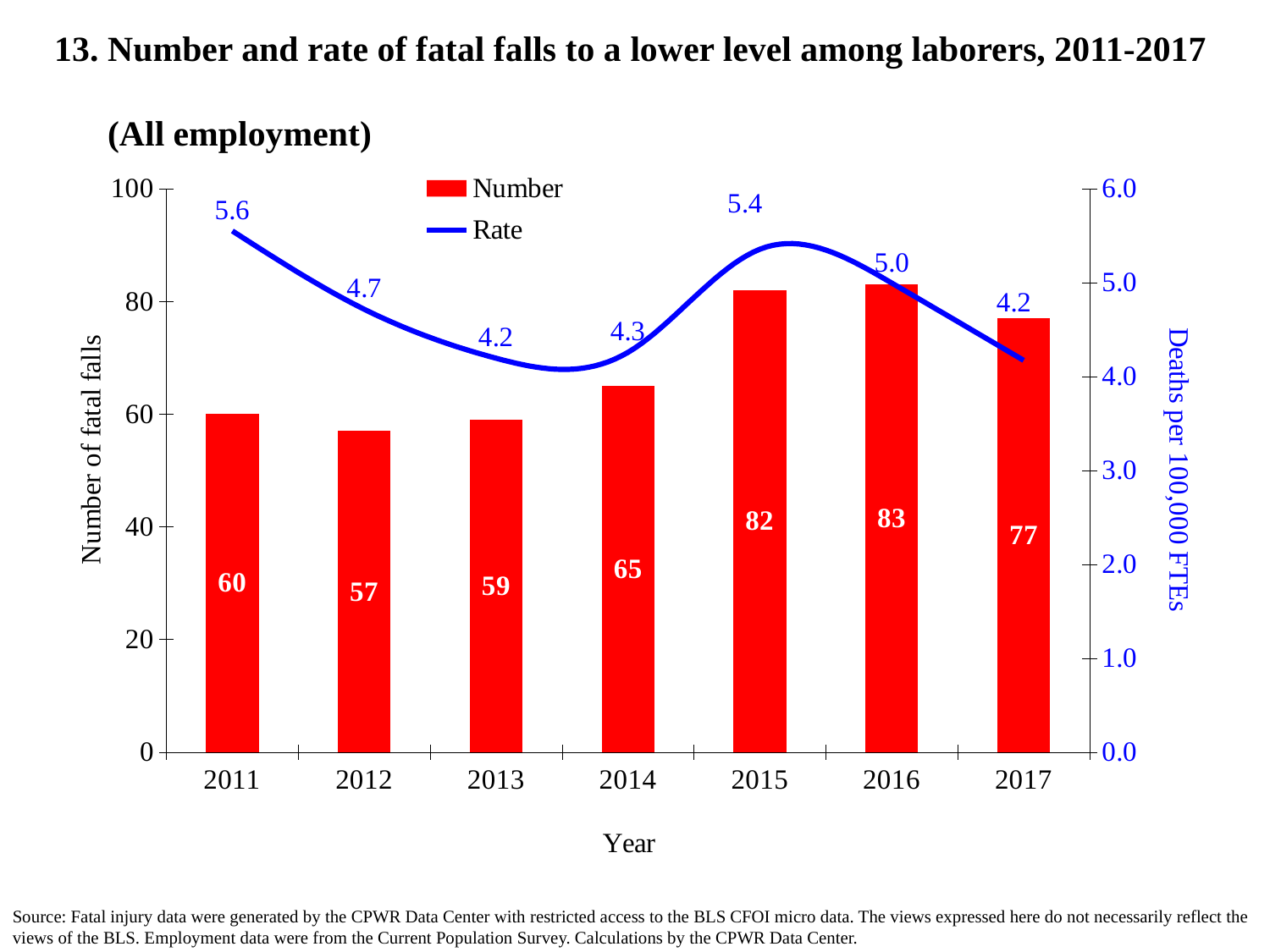
Which year has the lowest number of fatal falls? 2012 Is the number of fatal falls in 2015 greater or less than 80? greater Which year has the highest number of fatal falls? 2016 What is the difference in the number of fatal falls between 2016 and 2011? 23 How many years are shown on the x axis? 7 What kind of chart is used to show the Number series? bar chart Which year has the highest rate of fatal falls? 2011 Which year has a higher number of fatal falls, 2014 or 2017? 2017 How many series does the legend list? 2 What is the label of the right-hand vertical axis? Deaths per 100,000 FTEs What is the rate of fatal falls in 2011? 5.6 What is the number of fatal falls in 2015? 82